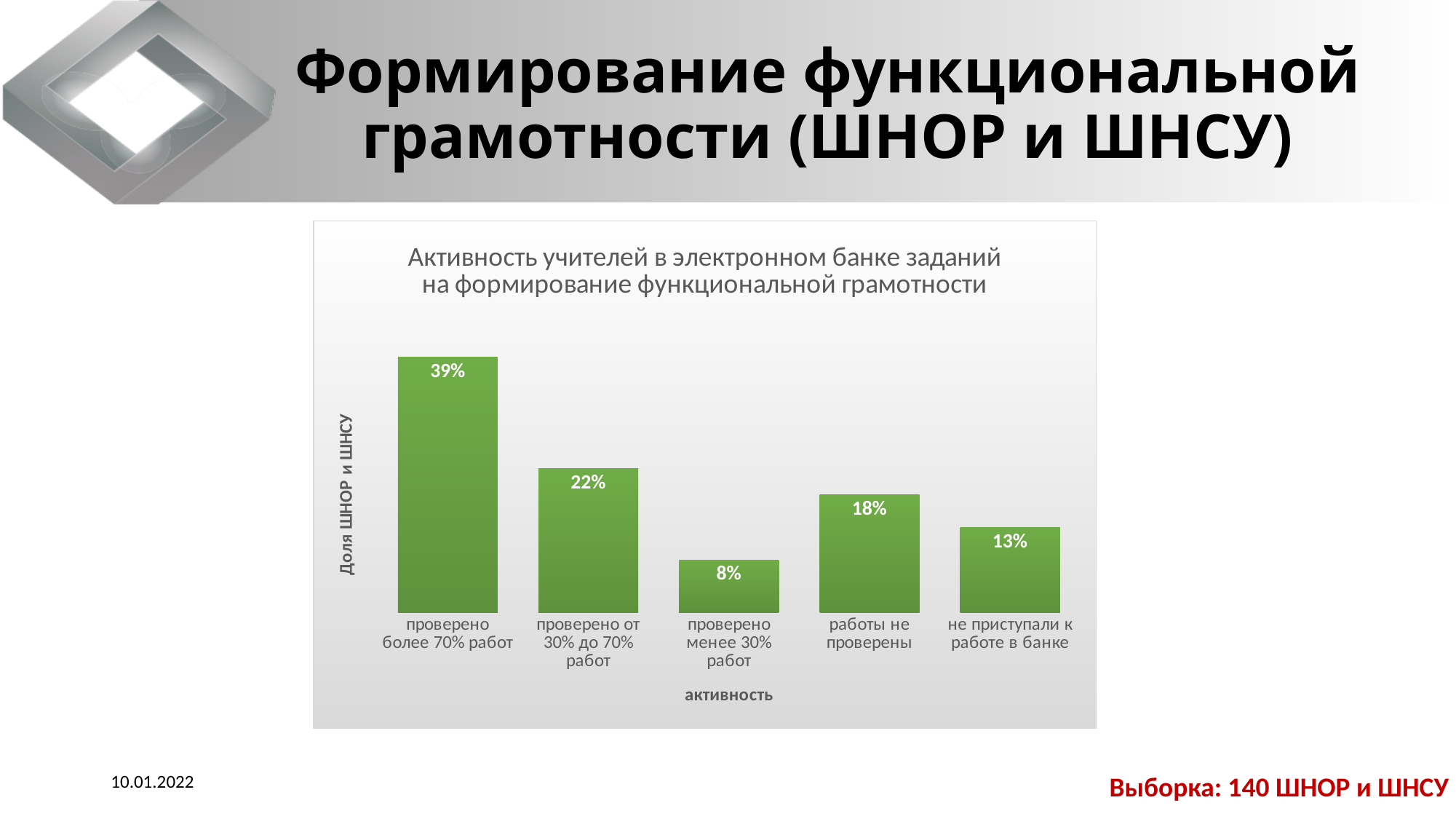
What is the difference between the values for 'проверено более 70% работ' and 'проверено от 30% до 70% работ'? 17% Which category has the highest value? проверено более 70% работ What kind of chart is shown on the slide? bar chart Which is larger: the value for 'работы не проверены' or the value for 'не приступали к работе в банке'? работы не проверены Which category has the lowest value? проверено менее 30% работ What is the value for the category 'проверено от 30% до 70% работ'? 22% What is the value for the category 'не приступали к работе в банке'? 13% What is the value for the category 'проверено менее 30% работ'? 8% How many categories are shown on the x axis? 5 What is the value for the category 'работы не проверены'? 18% What is the title of the chart? Активность учителей в электронном банке заданий на формирование функциональной грамотности What is the value for the category 'проверено более 70% работ'? 39%